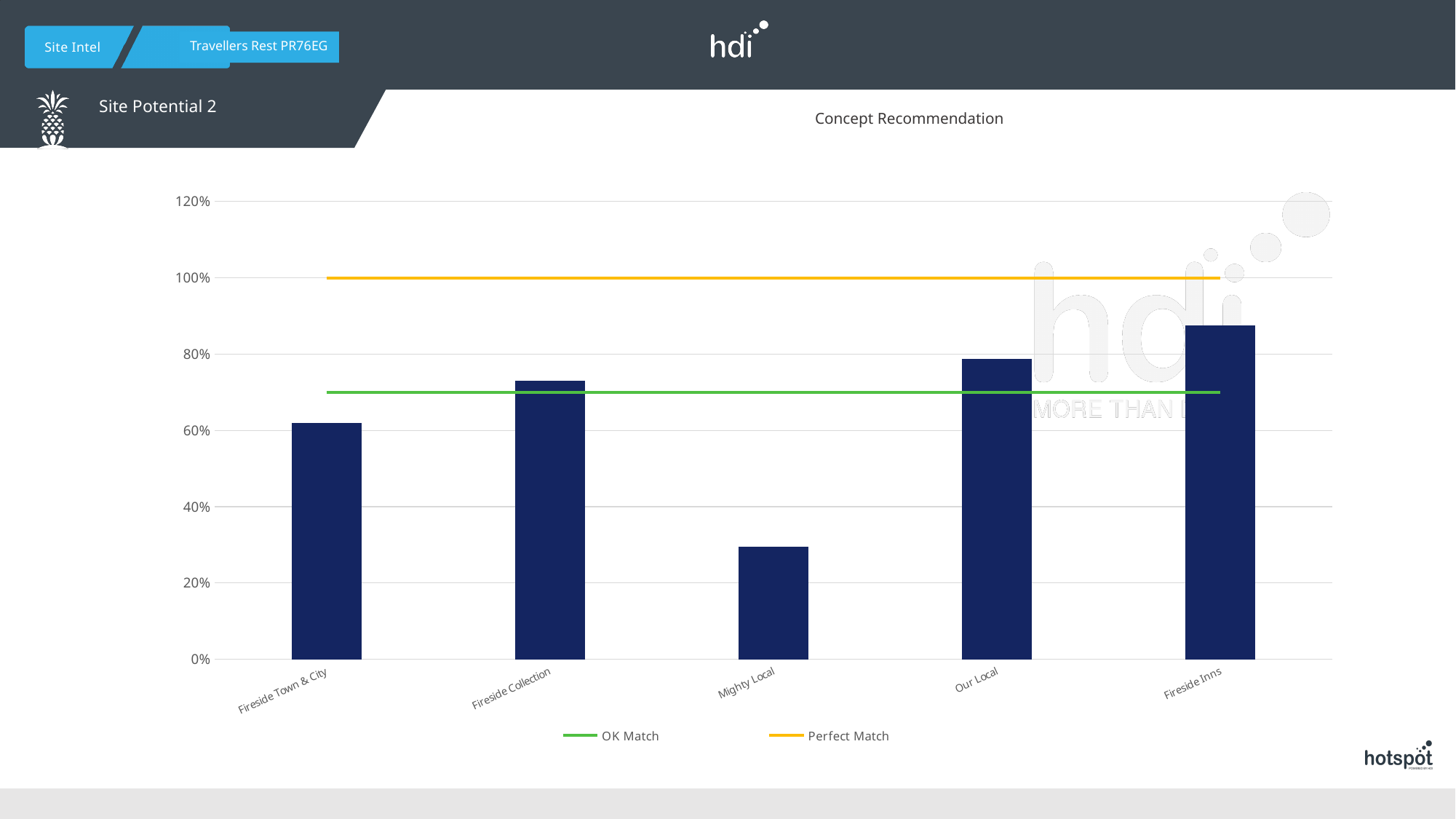
What is the title of the chart? Concept Recommendation How many entries does the legend list? 2 At what level is the Perfect Match line drawn? 100% Is the value for Mighty Local greater or less than 40%? less What kind of chart is shown on the slide? bar chart How many concepts (categories) are plotted on the x axis? 5 Which is larger, the value for Our Local or the value for Fireside Collection? Our Local Which concept has the highest bar? Fireside Inns Is the value for Fireside Town & City greater or less than 80%? less Is the value for Fireside Inns greater or less than 80%? greater Which concept has the lowest bar? Mighty Local